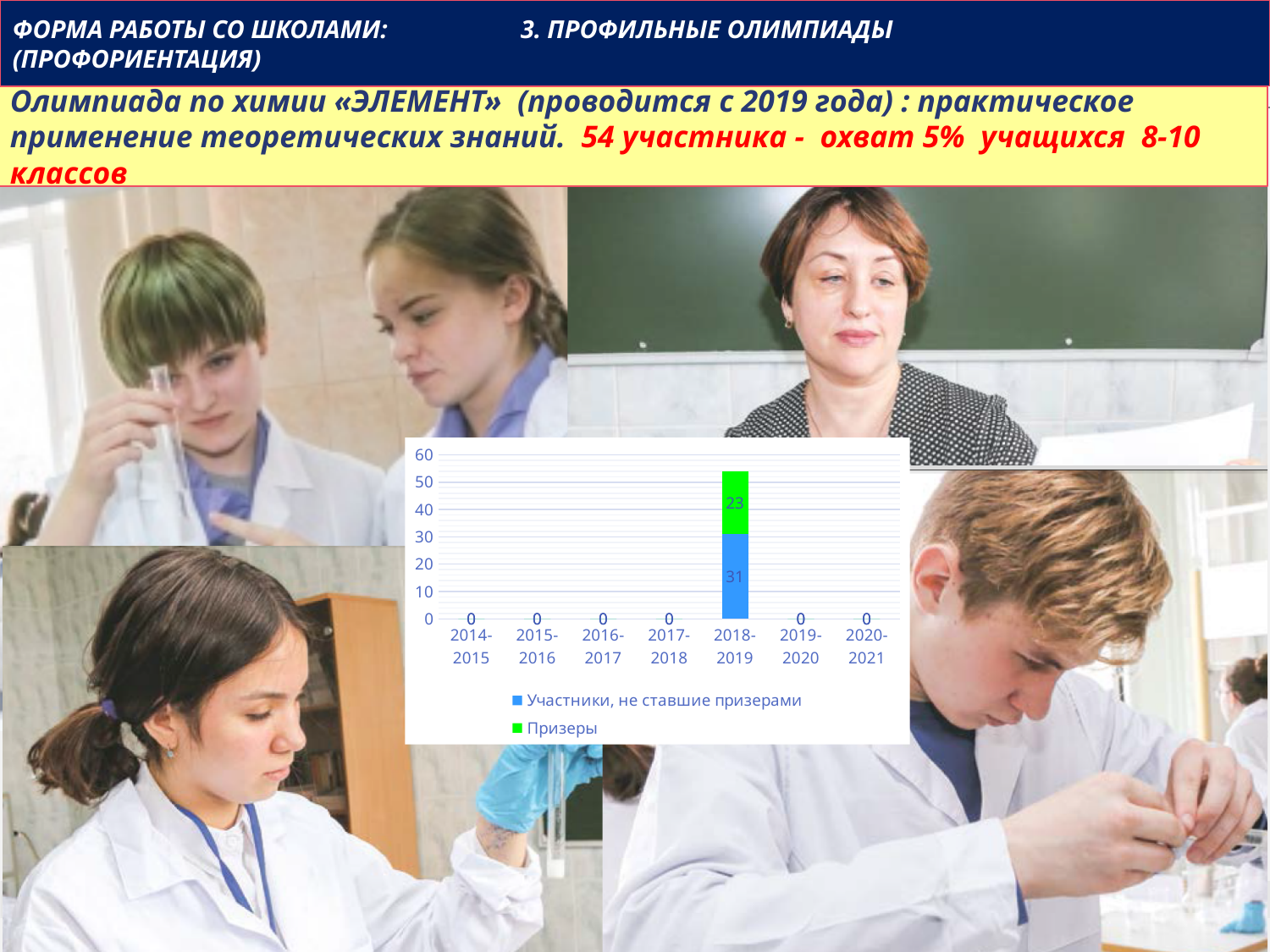
How many academic-year categories are shown on the x axis of the chart? 7 What is the value for 'Призеры' in 2018-2019? 23 What is the total of the stacked bar for 2018-2019? 54 In 2018-2019, which is larger: 'Участники, не ставшие призерами' or 'Призеры'? Участники, не ставшие призерами What is the value shown for 2017-2018 in the chart? 0 What kind of chart is shown on the slide? stacked bar chart What is the value for 'Участники, не ставшие призерами' in 2018-2019? 31 Which colour represents 'Призеры' in the chart? green Which academic year has the highest total in the chart? 2018-2019 What is the difference between the 'Участники, не ставшие призерами' value and the 'Призеры' value in 2018-2019? 8 How many series does the chart legend list? 2 Is the total value of the 2018-2019 bar greater or less than 50? greater